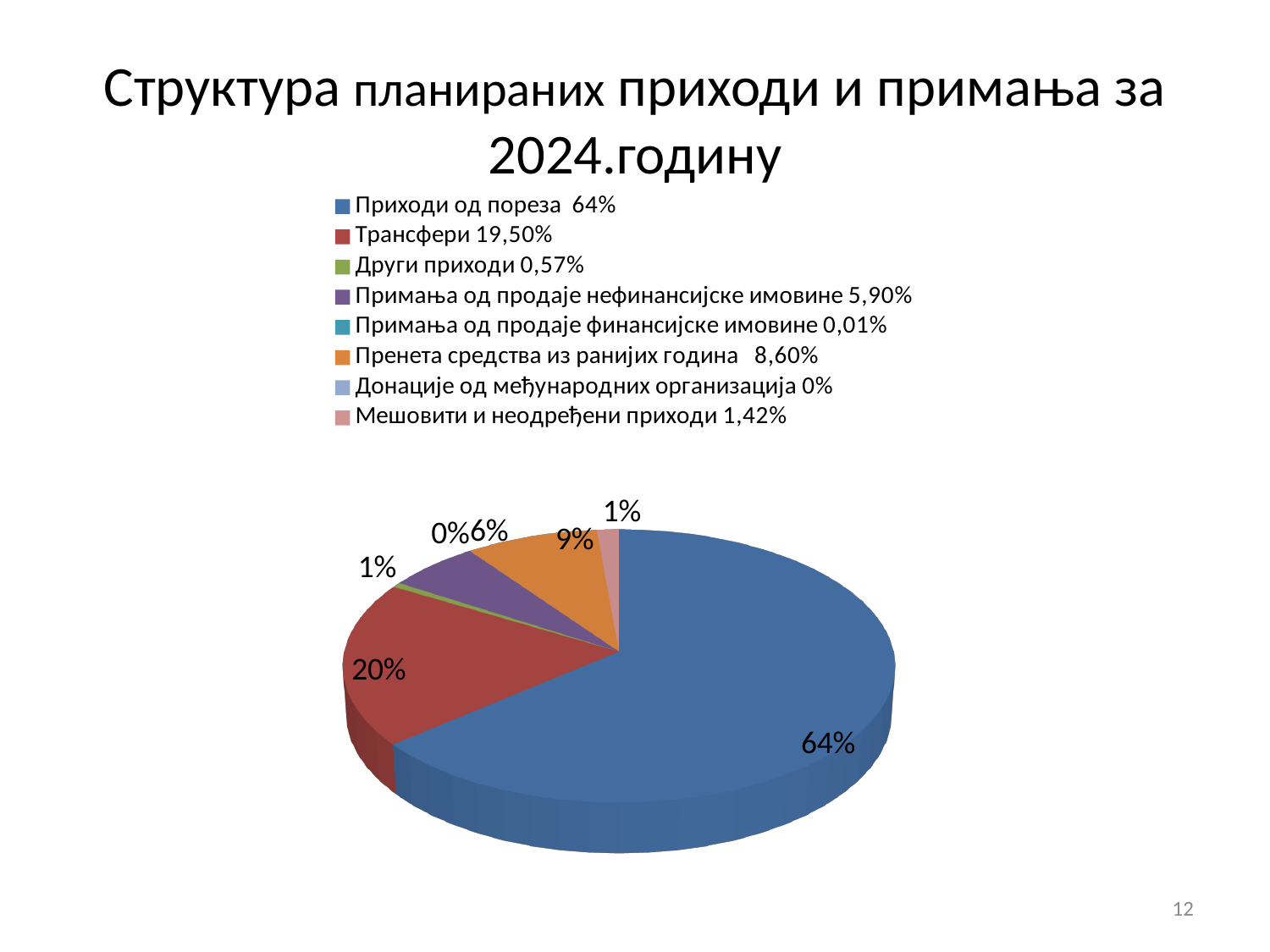
What kind of chart is shown on the slide? pie chart Which category has the smallest share according to the legend? Донације од међународних организација What percentage does the legend give for Примања од продаје нефинансијске имовине? 5,90% What percentage does the legend give for Мешовити и неодређени приходи? 1,42% What data label is shown on the Приходи од пореза slice of the pie? 64% Which category has the largest share of the pie? Приходи од пореза What colour is the slice for Приходи од пореза? blue By how many percentage points does the share for Приходи од пореза exceed the share for Трансфери, using the legend values? 44,50 Which is larger, the share for Трансфери or the share for Пренета средства из ранијих година? Трансфери What percentage does the legend give for Трансфери? 19,50% What percentage does the legend give for Пренета средства из ранијих година? 8,60% How many entries does the legend of the pie chart list? 8